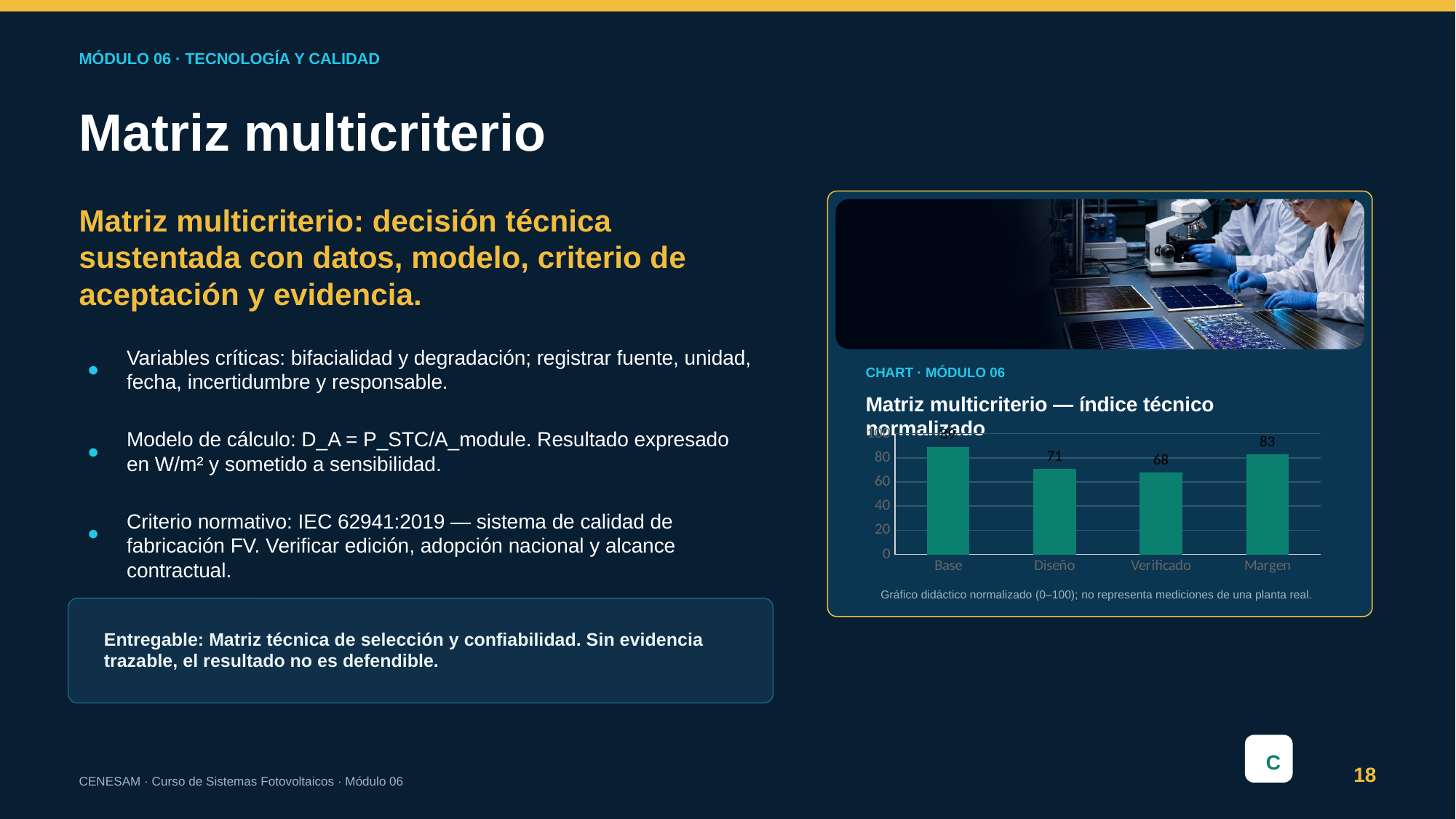
What is the value for Margen? 83 What is the value for Verificado? 68 What is the value for Diseño? 71 What is the difference between the values for Margen and Diseño? 12 What is the difference between the values for Diseño and Verificado? 3 What is the title of the chart? Matriz multicriterio — índice técnico normalizado What kind of chart is shown on the slide? bar chart How many categories are shown on the x axis? 4 Which category has the lowest value? Verificado Which category has the highest value? Base Is the value for Base greater or less than 80? greater Which is larger, the value for Margen or the value for Diseño? Margen